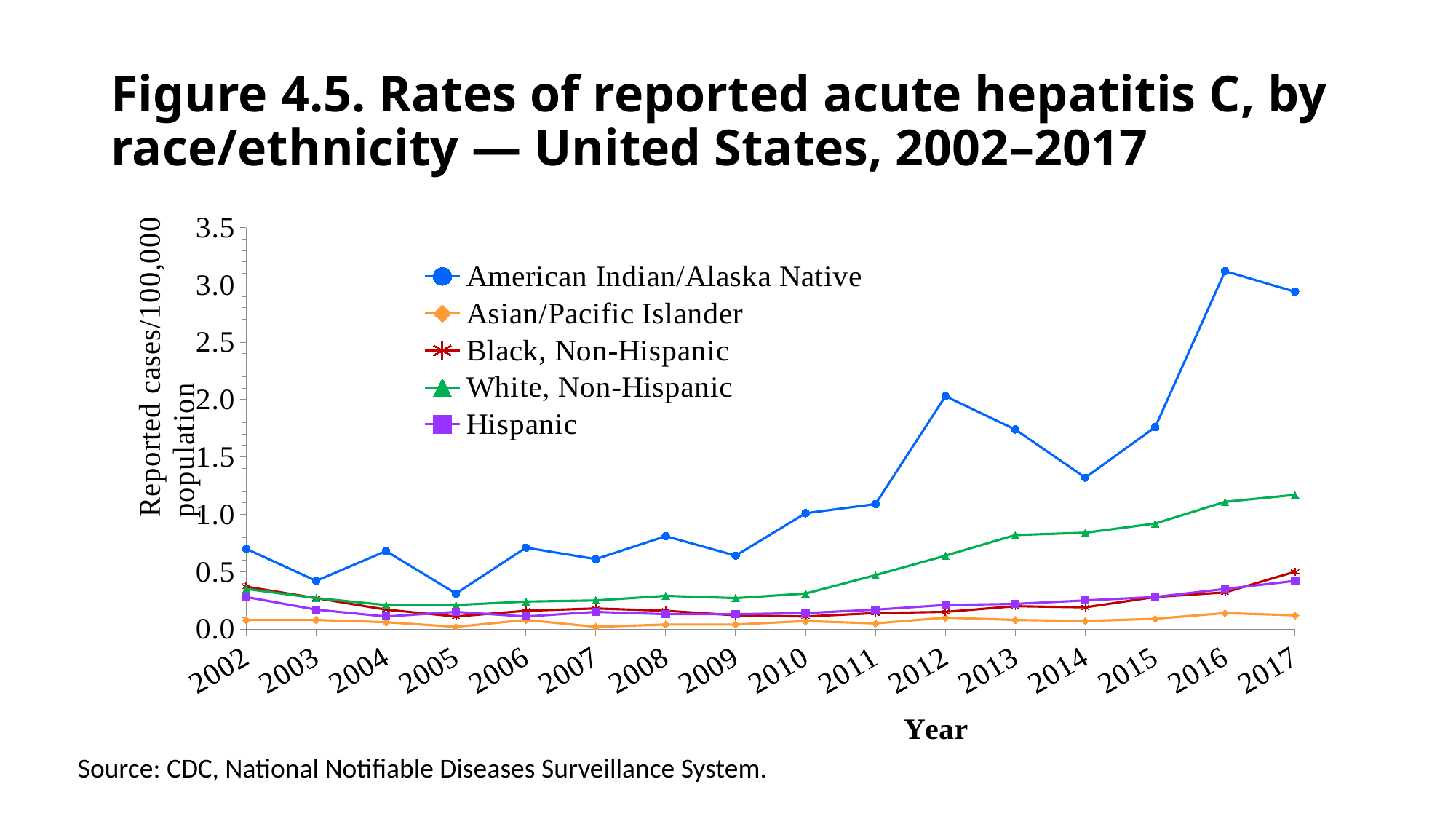
What is the title of the x axis? Year In which year does the American Indian/Alaska Native series reach its highest value? 2016 Is the value for American Indian/Alaska Native in 2014 greater or less than 1.5? less Is the value for American Indian/Alaska Native in 2016 greater or less than 3.0? greater Which race/ethnicity group has the highest rate in 2017? American Indian/Alaska Native What kind of chart is shown on the slide? Line chart Which race/ethnicity group has the lowest rate in 2017? Asian/Pacific Islander How many years are shown along the x axis? 16 For American Indian/Alaska Native, which year has the larger value, 2012 or 2013? 2012 Is the value for White, Non-Hispanic in 2017 greater or less than 1.0? greater Does the White, Non-Hispanic series rise or fall from 2010 to 2017? Rise How many series does the legend list? 5